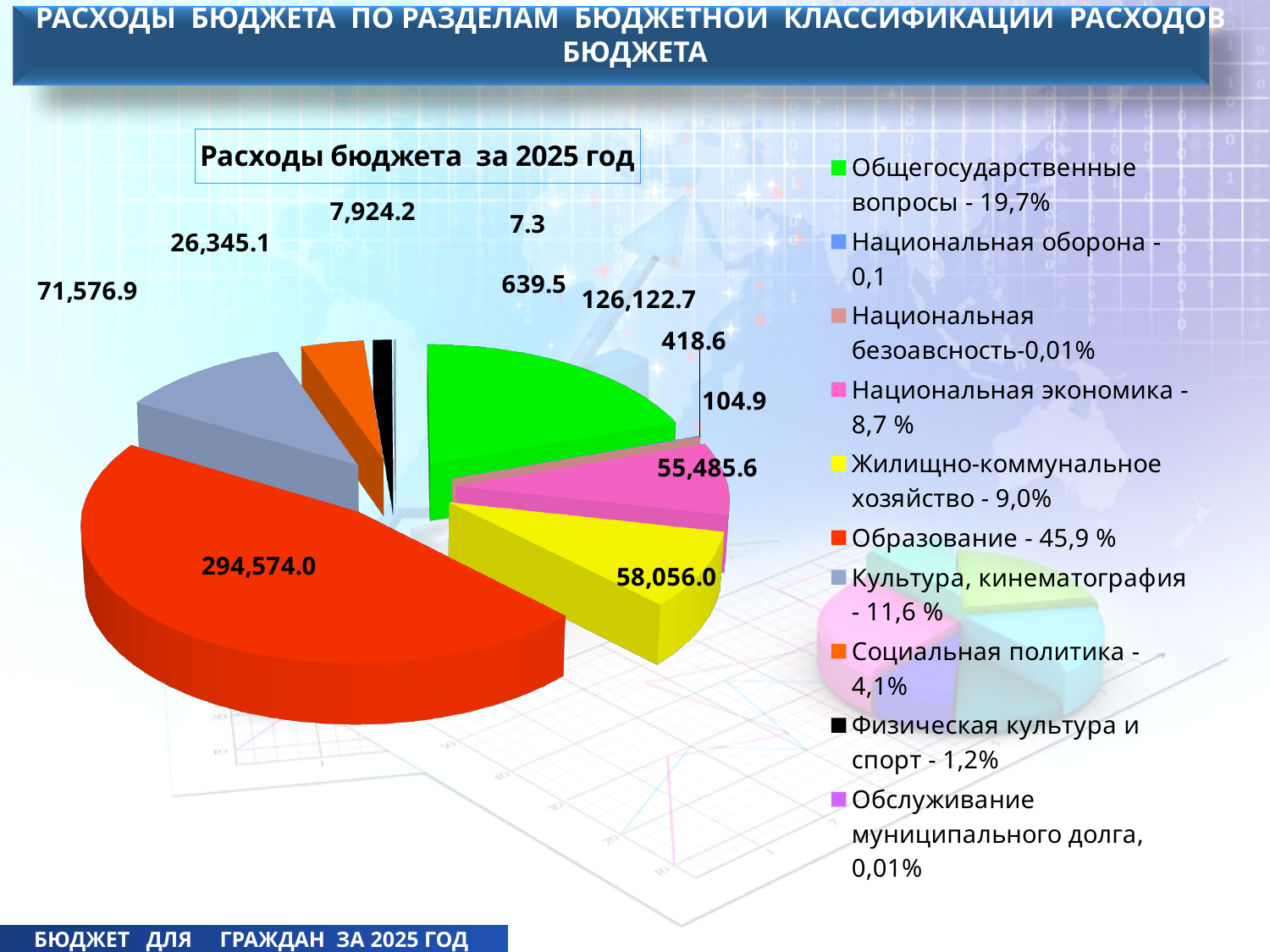
What is the value shown for Социальная политика? 26,345.1 What share of the pie does Культура, кинематография account for, according to the legend? 11,6 % What is the difference between the value for Жилищно-коммунальное хозяйство (58,056.0) and the value for Национальная экономика (55,485.6)? 2,570.4 What is the value shown for Общегосударственные вопросы? 126,122.7 Which is larger, the value for Жилищно-коммунальное хозяйство or the value for Национальная экономика? Жилищно-коммунальное хозяйство What is the title of the chart? Расходы бюджета за 2025 год How many entries does the chart legend list? 10 What is the value shown for Образование? 294,574.0 What share of the pie does Образование account for, according to the legend? 45,9 % What is the value shown for Культура, кинематография? 71,576.9 Which category has the largest slice of the pie? Образование What kind of chart is shown on the slide? Pie chart